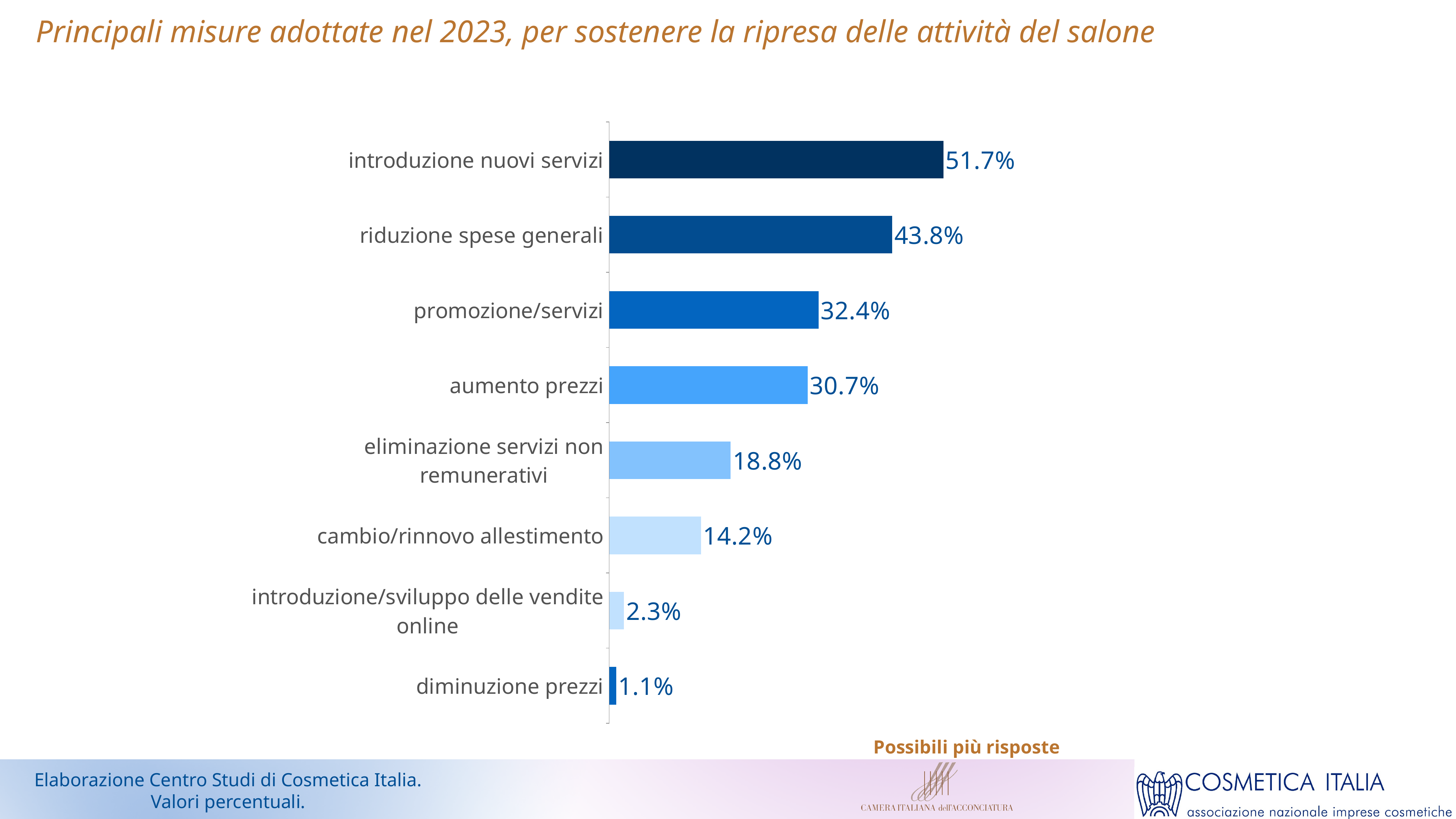
What is the value for 'cambio/rinnovo allestimento'? 14.2% Which category has the highest value? introduzione nuovi servizi What is the value for 'introduzione nuovi servizi'? 51.7% What is the difference between 'introduzione nuovi servizi' and 'riduzione spese generali'? 7.9% How many categories are shown in the chart? 8 What is the value for 'riduzione spese generali'? 43.8% What kind of chart is shown on the slide? bar chart What is the difference between 'eliminazione servizi non remunerativi' and 'cambio/rinnovo allestimento'? 4.6% What is the value for 'introduzione/sviluppo delle vendite online'? 2.3% Which category has the lowest value? diminuzione prezzi What is the title of the slide? Principali misure adottate nel 2023, per sostenere la ripresa delle attività del salone Which is larger: 'promozione/servizi' or 'aumento prezzi'? promozione/servizi